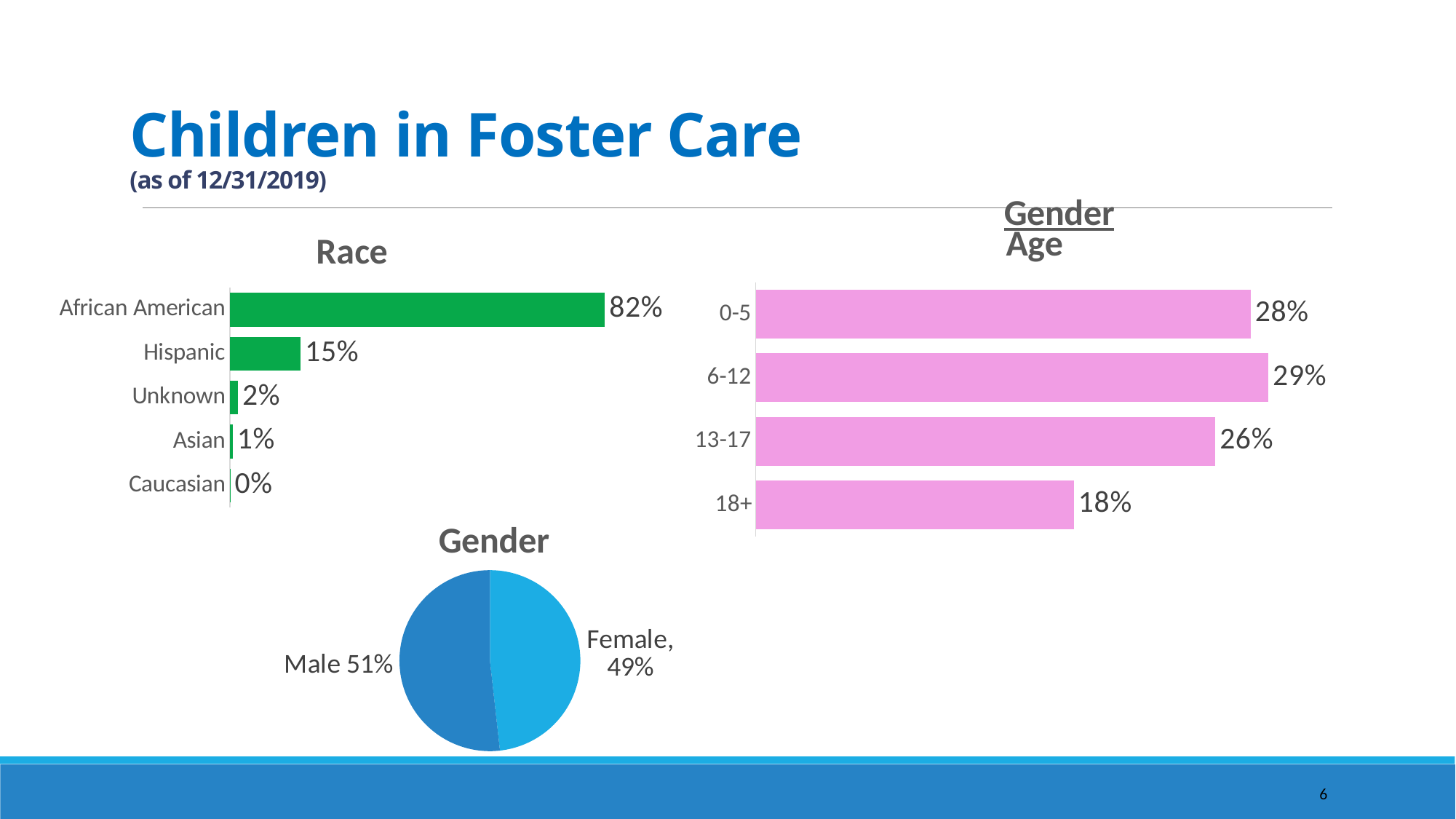
How many categories does the Race chart show? 5 In the Age chart, which age group has the lowest value? 18+ In the Race chart, what is the value for Hispanic? 15% In the Race chart, what is the difference between the African American and Hispanic values? 67% In the Gender pie chart, what share is Male? 51% In the Race chart, what is the value for African American? 82% In the Race chart, which category has the lowest value? Caucasian What kind of chart is the Gender chart? pie chart In the Age chart, which age group has the highest value? 6-12 In the Age chart, what is the value for 13-17? 26% In the Gender pie chart, which slice is larger, Male or Female? Male In the Age chart, what is the difference between the 0-5 and 18+ values? 10%